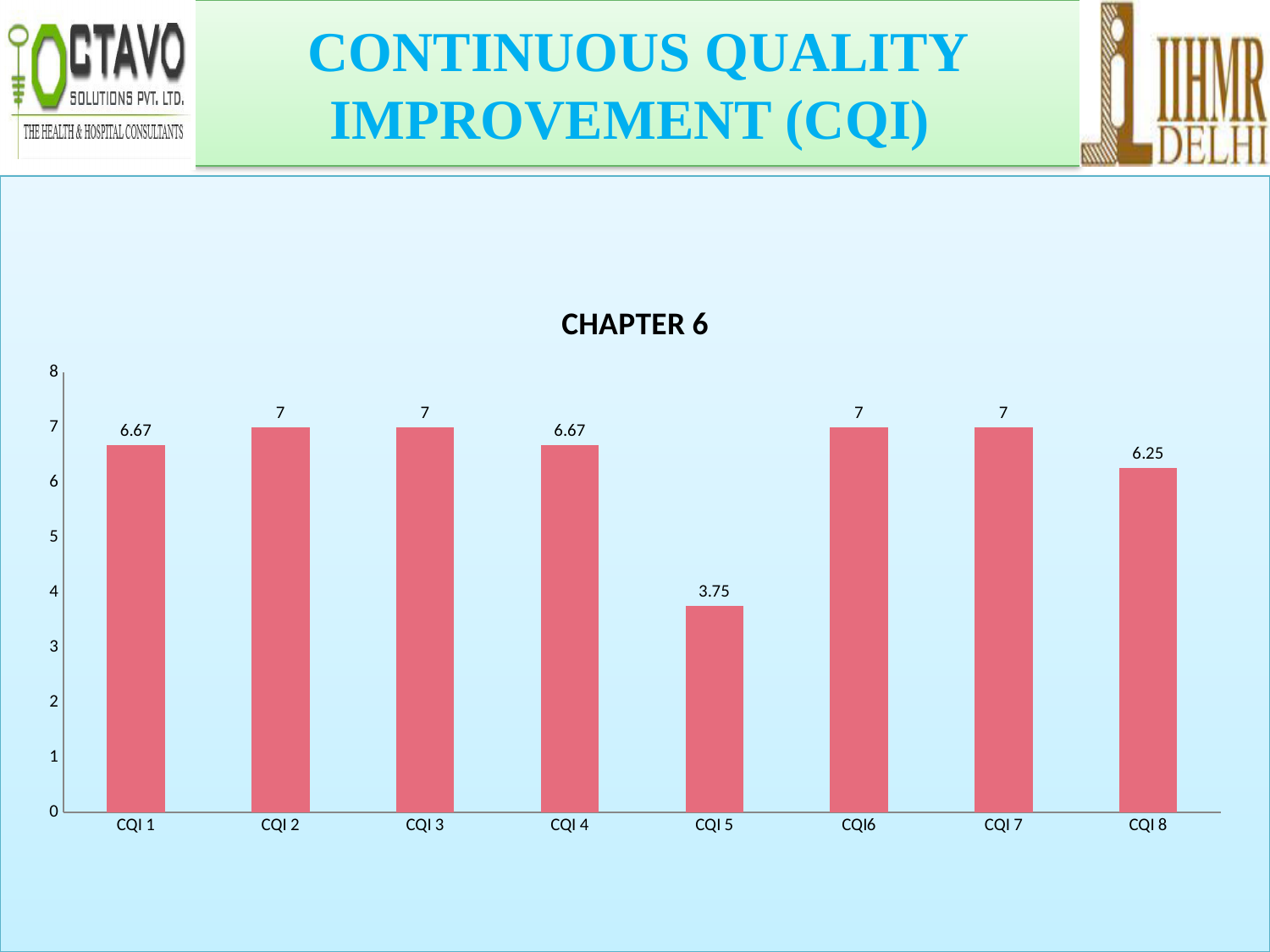
What is the value for CQI 8? 6.25 What is the title of the chart? CHAPTER 6 What is the value for CQI 1? 6.67 What is the value for CQI 4? 6.67 What is the value for CQI 5? 3.75 Which category has the lowest value? CQI 5 What is the difference between the values for CQI 1 and CQI 8? 0.42 Which is larger, the value for CQI 3 or the value for CQI 8? CQI 3 What kind of chart is shown on the slide? bar chart How many categories are shown on the x axis? 8 Is the value for CQI 5 greater or less than 4? less What is the difference between the values for CQI 2 and CQI 5? 3.25